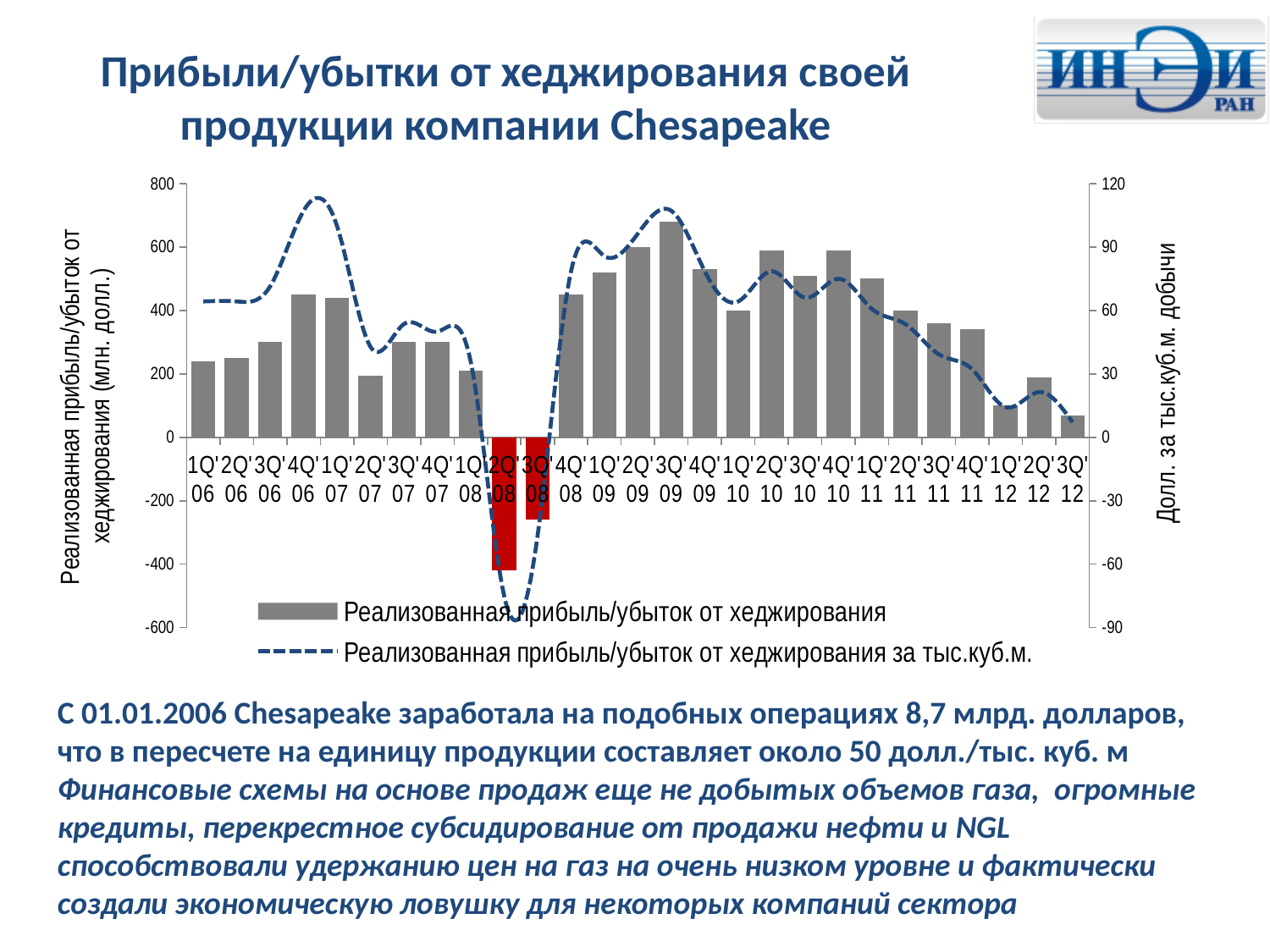
How many quarters are plotted along the x axis? 27 Is the bar value for 1Q'12 greater or less than 200? less Is the bar value for 3Q'09 greater or less than 600? greater Do the bars generally rise or fall from 3Q'09 to 3Q'12? fall Which bar is larger, 2Q'09 or 1Q'06? 2Q'09 How many series does the legend list? 2 What kind of chart is shown on the slide? A combination bar and line chart Is the bar value for 4Q'06 greater or less than 400? greater Which quarter has the highest bar for realized hedging profit/loss? 3Q'09 What does the dashed line series represent according to the legend? Реализованная прибыль/убыток от хеджирования за тыс.куб.м. Which quarter has the lowest bar for realized hedging profit/loss? 2Q'08